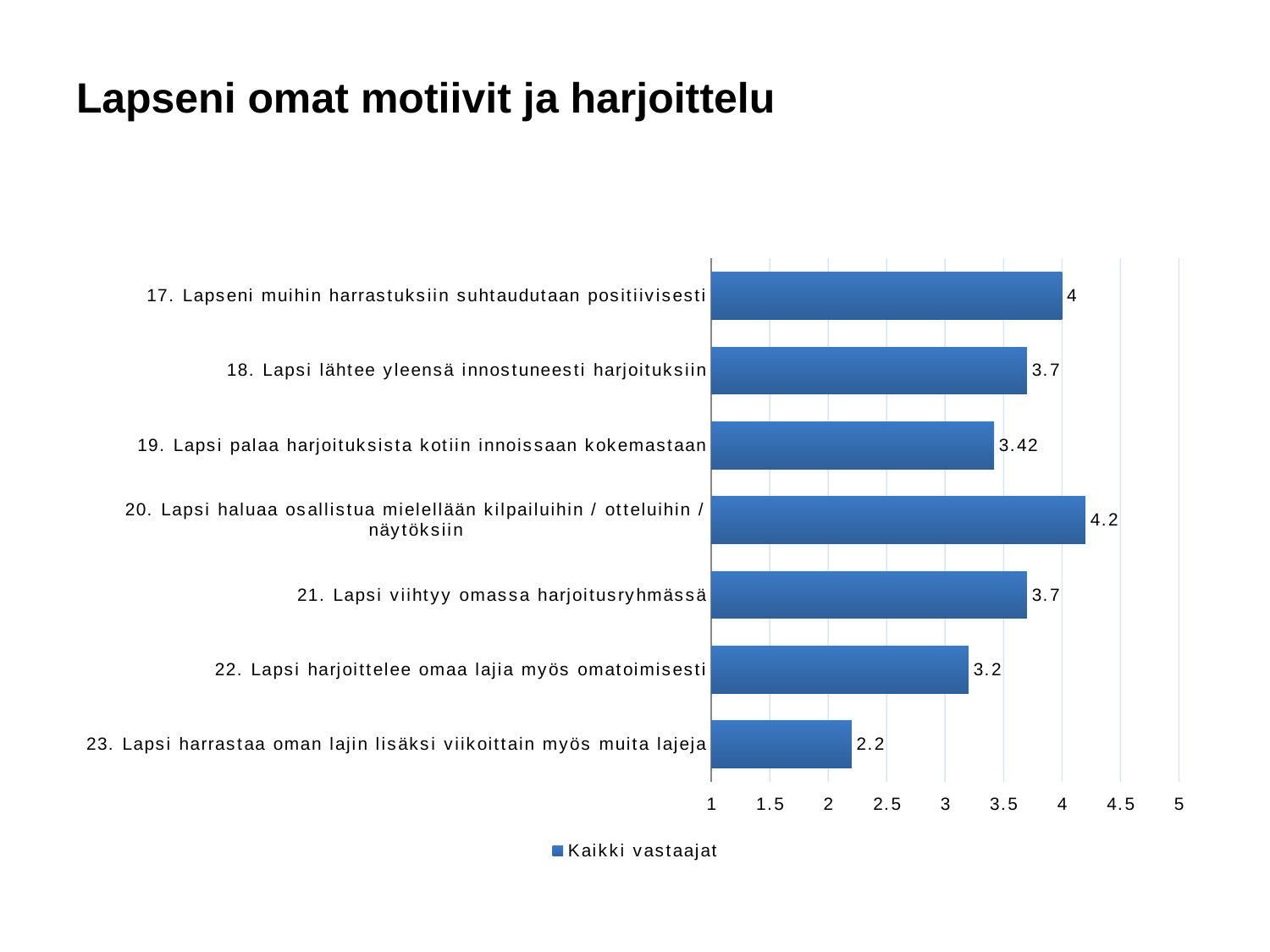
What is the difference between the values for item 17 and item 22? 0.8 What is the name of the series shown in the legend? Kaikki vastaajat What is the value for item 19, "Lapsi palaa harjoituksista kotiin innoissaan kokemastaan"? 3.42 What is the value for item 17, "Lapseni muihin harrastuksiin suhtaudutaan positiivisesti"? 4 Which has a larger value, item 19 or item 22? 19. Lapsi palaa harjoituksista kotiin innoissaan kokemastaan What is the difference between the values for item 20 and item 23? 2 How many items (categories) are shown in the chart? 7 What is the value for item 23, "Lapsi harrastaa oman lajin lisäksi viikoittain myös muita lajeja"? 2.2 What kind of chart is shown on the slide? Bar chart How many series does the legend list? 1 Which item has the lowest value? 23. Lapsi harrastaa oman lajin lisäksi viikoittain myös muita lajeja Which item has the highest value? 20. Lapsi haluaa osallistua mielellään kilpailuihin / otteluihin / näytöksiin